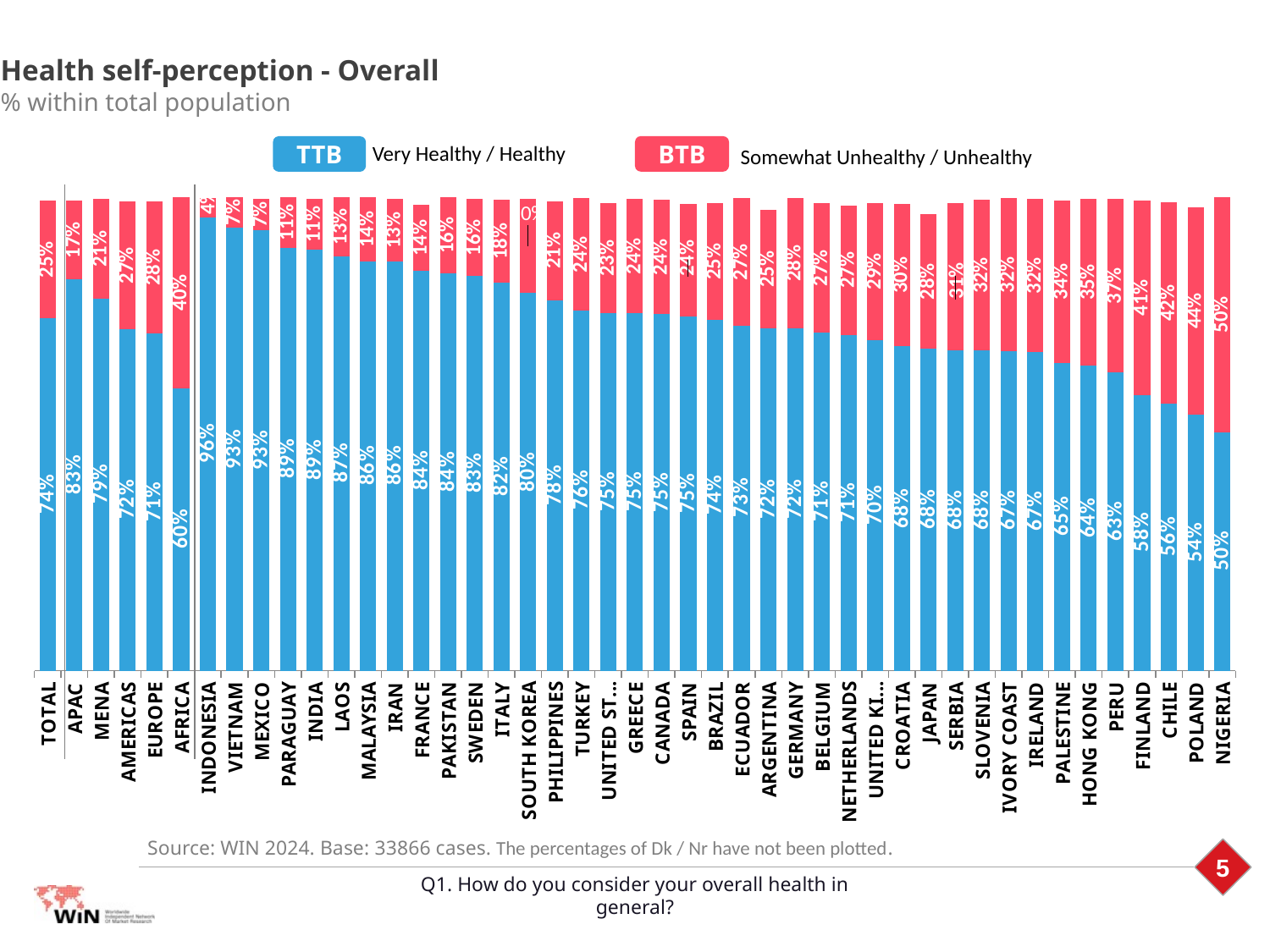
Which country has the highest TTB (Very Healthy / Healthy) value? Indonesia Do the TTB values generally rise or fall moving from Indonesia to Nigeria along the x axis? Fall How many series does the legend list? 2 What is the BTB (Somewhat Unhealthy / Unhealthy) value for Africa? 40% Which has a larger BTB value, Poland or Peru? Poland What is the TTB value for Total? 74% What kind of chart is shown on the slide? Stacked bar chart Which country has the lowest TTB (Very Healthy / Healthy) value? Nigeria Which colour represents BTB (Somewhat Unhealthy / Unhealthy) in the chart? Red What is the total of the TTB and BTB segments for Nigeria? 100% What is the difference between the TTB values for Indonesia and Nigeria? 46 percentage points What is the TTB (Very Healthy / Healthy) value for Indonesia? 96%